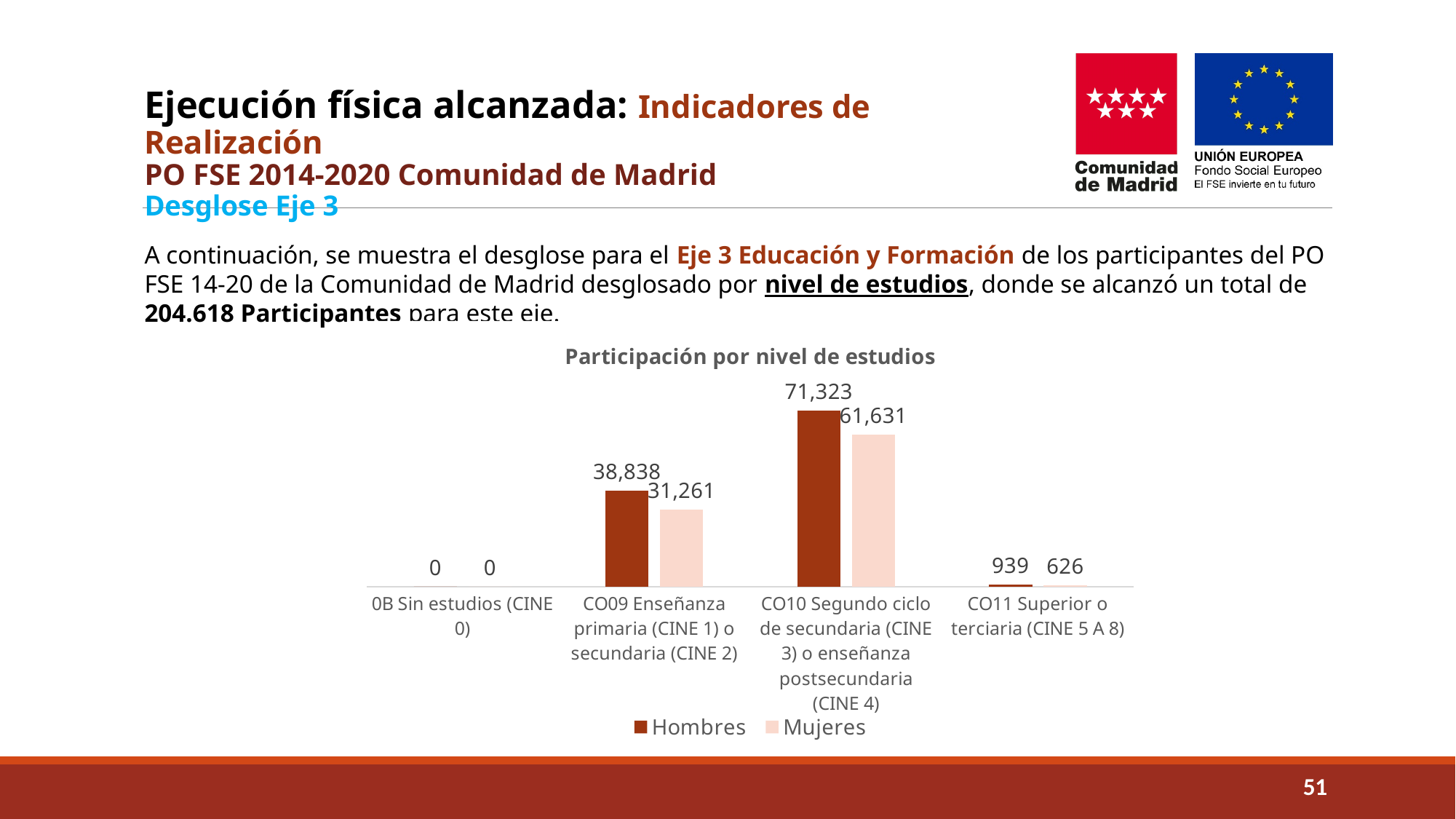
What is the value for Hombres in the CO10 Segundo ciclo de secundaria (CINE 3) o enseñanza postsecundaria (CINE 4) category? 71,323 What type of chart is shown on the slide? Bar chart What is the difference between Hombres and Mujeres in the CO11 Superior o terciaria (CINE 5 A 8) category? 313 What is the value for Mujeres in the 0B Sin estudios (CINE 0) category? 0 What is the value for Mujeres in the CO09 Enseñanza primaria (CINE 1) o secundaria (CINE 2) category? 31,261 What is the difference between Hombres and Mujeres in the CO10 Segundo ciclo de secundaria (CINE 3) o enseñanza postsecundaria (CINE 4) category? 9,692 How many categories are shown on the x axis of the chart? 4 Which category has the highest value for Mujeres? CO10 Segundo ciclo de secundaria (CINE 3) o enseñanza postsecundaria (CINE 4) In the CO09 Enseñanza primaria (CINE 1) o secundaria (CINE 2) category, which is larger, Hombres or Mujeres? Hombres Which category has the lowest value for Hombres? 0B Sin estudios (CINE 0) How many series does the legend list? 2 What is the value for Hombres in the CO11 Superior o terciaria (CINE 5 A 8) category? 939